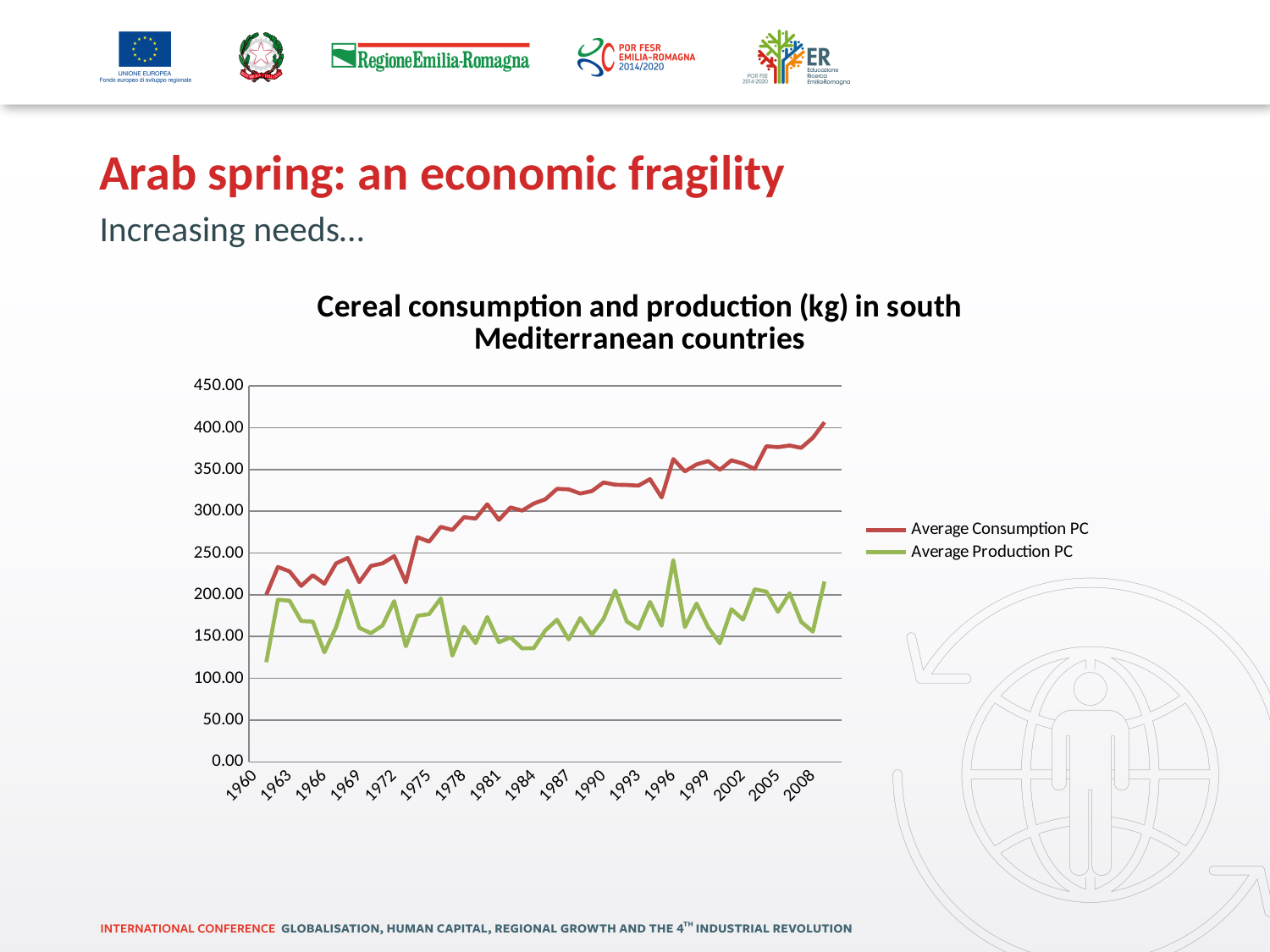
In 2008, which series has the larger value, Average Consumption PC or Average Production PC? Average Consumption PC How many year labels are shown on the horizontal axis of the chart? 17 Is the value for Average Consumption PC in 2008 greater or less than 350? greater Is the value for Average Production PC in 1996 greater or less than 200? greater What is the highest value shown on the vertical axis of the chart? 450.00 What is the title of the chart? Cereal consumption and production (kg) in south Mediterranean countries What kind of chart is shown on the slide? line chart Does the Average Consumption PC line generally rise or fall from 1960 to 2008? rise Which series is drawn in green in the chart? Average Production PC How many series does the chart legend list? 2